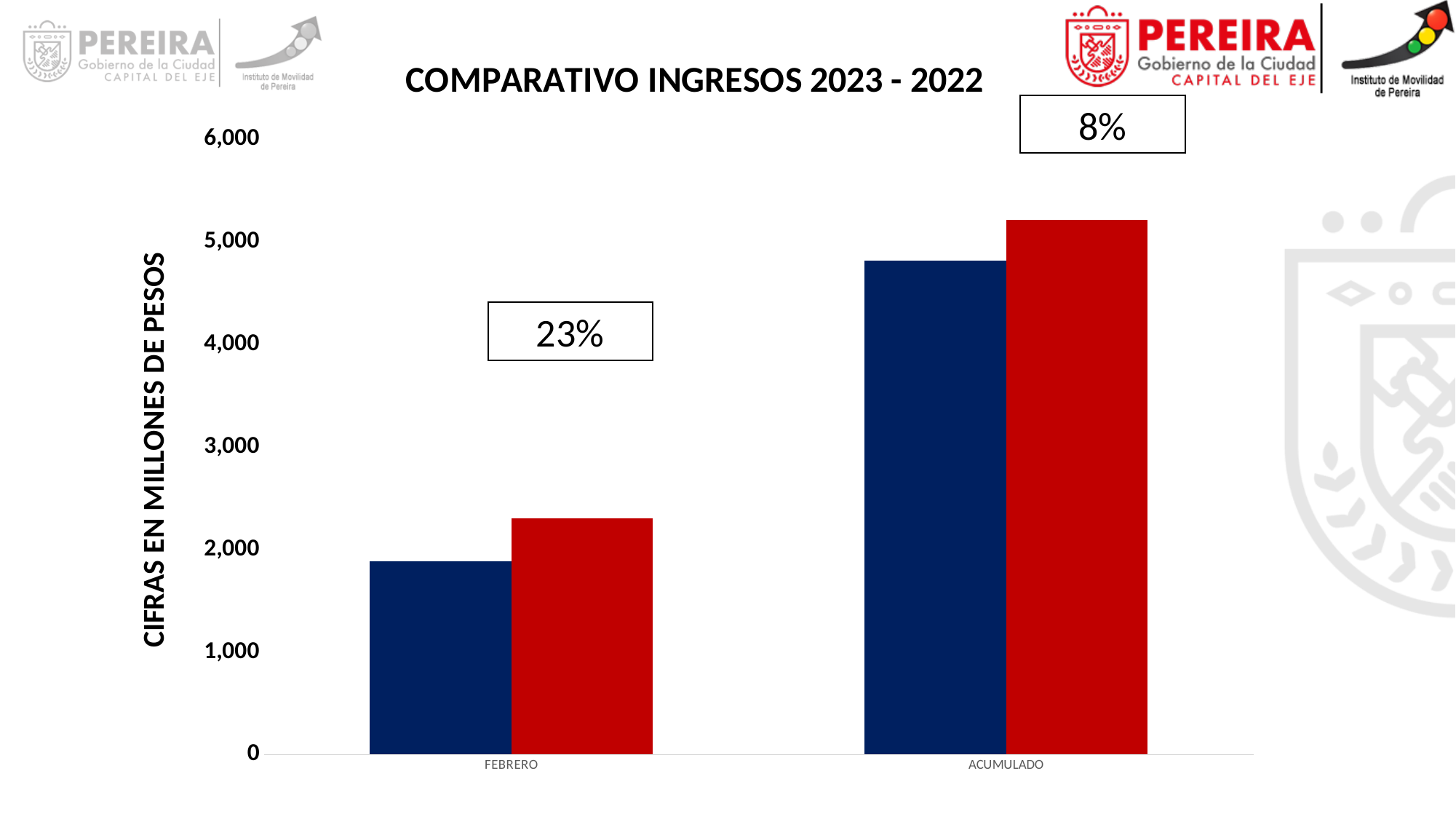
Is the value of the red bar for FEBRERO greater or less than 2,000? greater What percentage is shown in the box above the FEBRERO bars? 23% Is the value of the red bar for ACUMULADO greater or less than 5,000? greater Is the value of the dark blue bar for ACUMULADO greater or less than 5,000? less What is the title of the chart? COMPARATIVO INGRESOS 2023 - 2022 How many categories are shown on the x axis of the chart? 2 What is the label on the vertical axis of the chart? CIFRAS EN MILLONES DE PESOS What percentage is shown in the box above the ACUMULADO bars? 8% What kind of chart is shown on the slide? bar chart For ACUMULADO, which bar is taller, the dark blue bar or the red bar? the red bar How many bars are plotted in the chart in total? 4